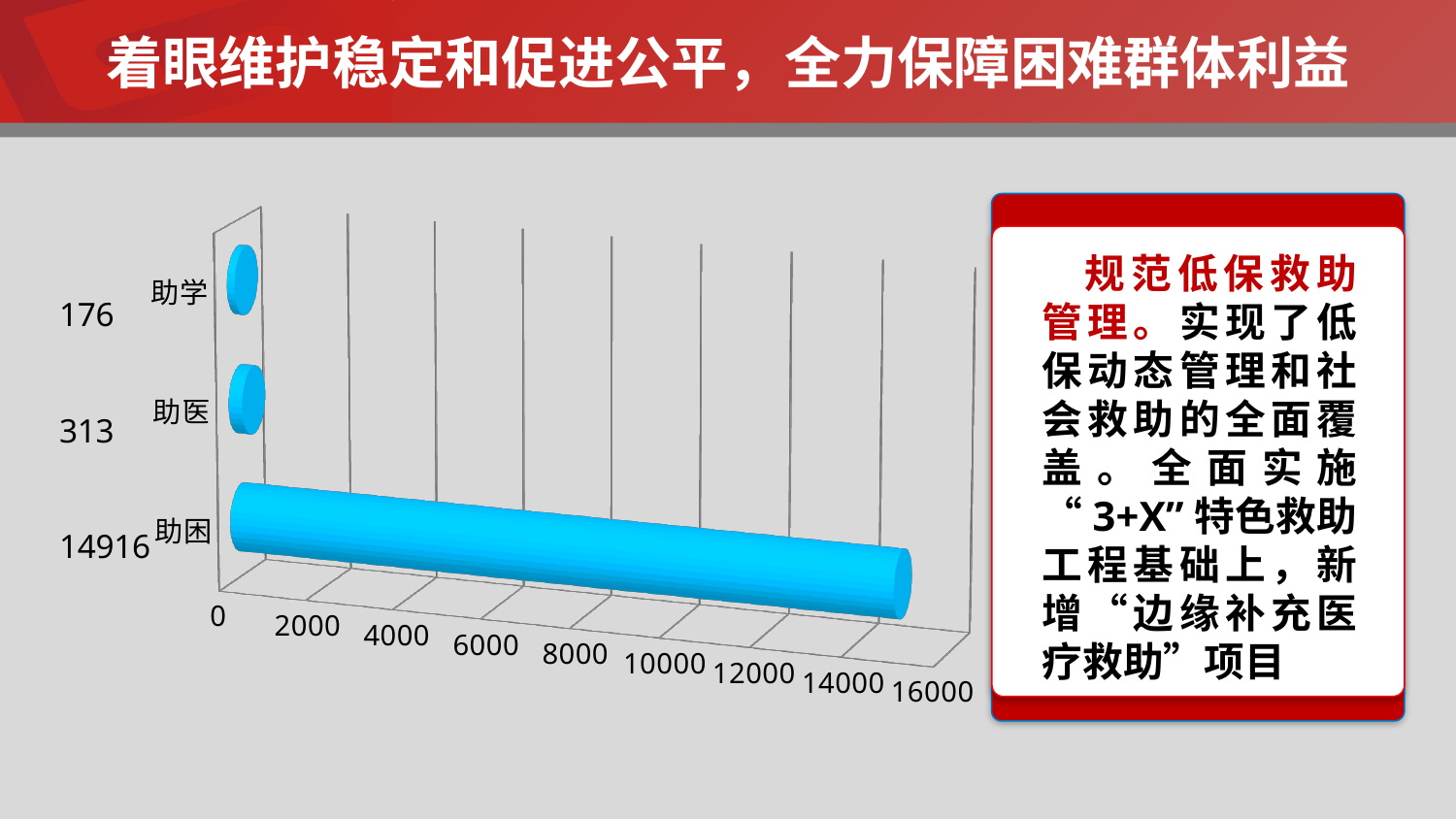
Is the value for 助困 greater or less than 14000? greater Which category has the lowest value? 助学 What kind of chart is shown on the slide? bar chart What is the difference between the values for 助医 and 助学? 137 What is the value for 助医? 313 How many categories are shown in the chart? 3 What is the value for 助学? 176 Which category has the highest value? 助困 What is the maximum value shown on the value axis of the chart? 16000 What is the difference between the values for 助困 and 助医? 14603 Which is larger, the value for 助医 or the value for 助学? 助医 What is the value for 助困? 14916